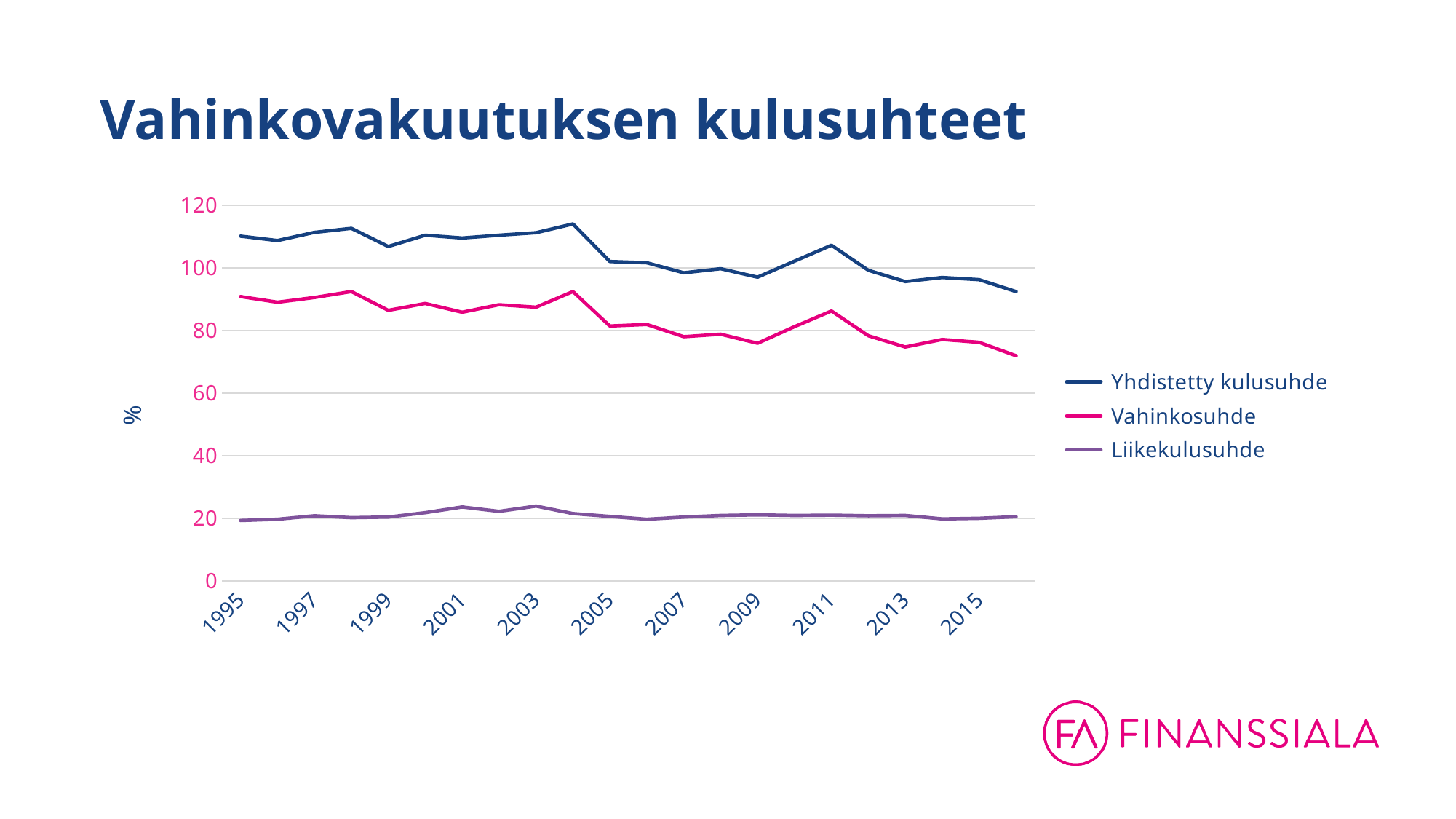
Is the value for Liikekulusuhde in 2001 greater or less than 20? greater Is the value for Yhdistetty kulusuhde in 1995 greater or less than 100? greater Which series has the highest values across the whole period? Yhdistetty kulusuhde What unit is shown on the y-axis label? % Is the value for Vahinkosuhde in 2016 greater or less than 80? less Which series has the lowest values across the whole period? Liikekulusuhde What kind of chart is shown on the slide? line chart How many series does the legend list? 3 In 2011, which is larger: Yhdistetty kulusuhde or Vahinkosuhde? Yhdistetty kulusuhde Does Yhdistetty kulusuhde rise or fall from 2011 to 2016? fall What is the title of the chart? Vahinkovakuutuksen kulusuhteet